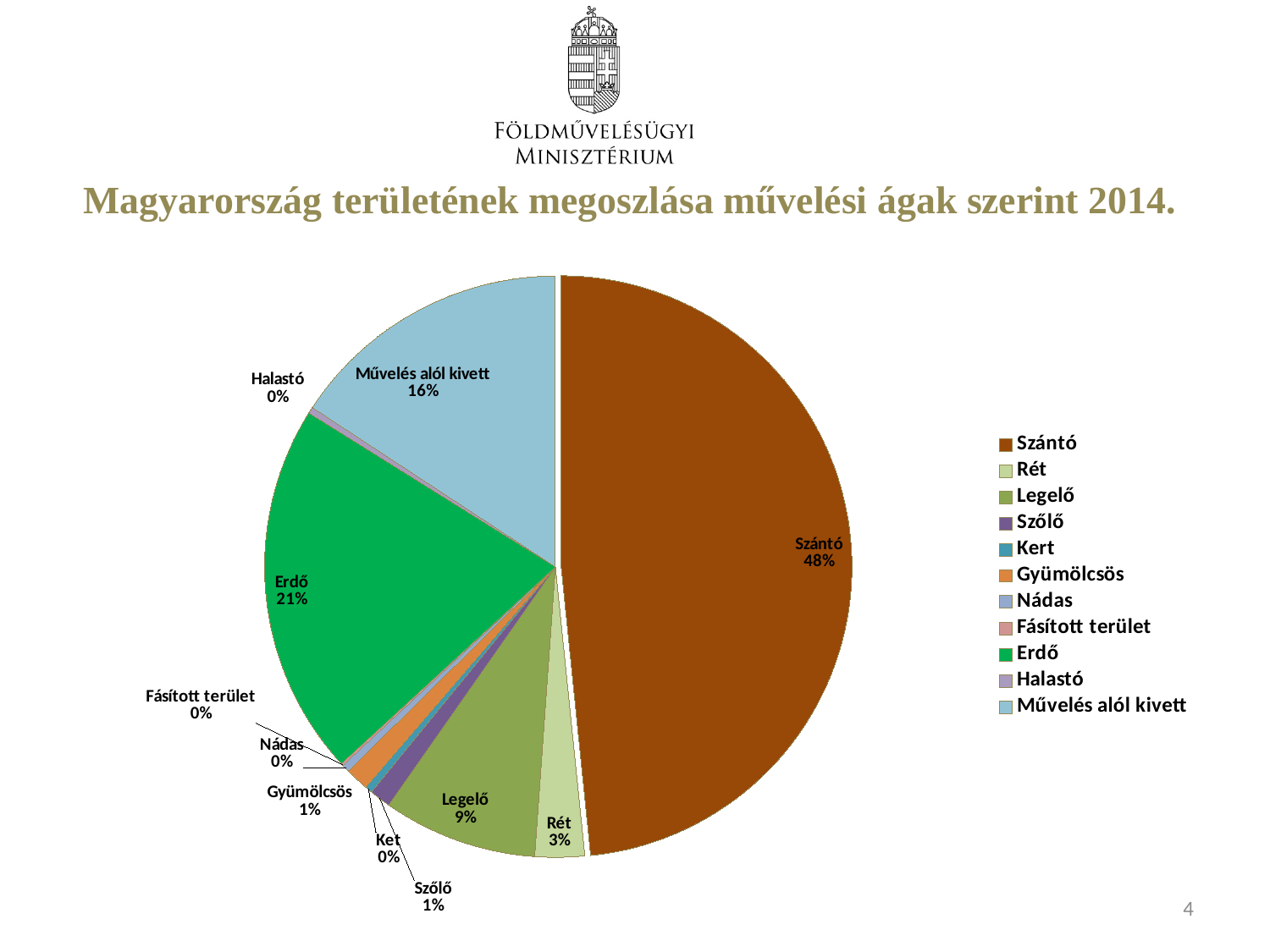
What percentage is shown for Gyümölcsös? 1% What is the difference in percentage points between Erdő and Művelés alól kivett? 5 What is the title of the chart? Magyarország területének megoszlása művelési ágak szerint 2014. What share of the pie does Szántó represent? 48% How many categories does the legend list? 11 What percentage is shown for Erdő? 21% Which category has the largest slice of the pie? Szántó Which is larger, the share for Legelő or the share for Rét? Legelő What kind of chart is shown on the slide? Pie chart What percentage is shown for Művelés alól kivett? 16% What percentage is shown for Legelő? 9% What percentage is shown for Rét? 3%